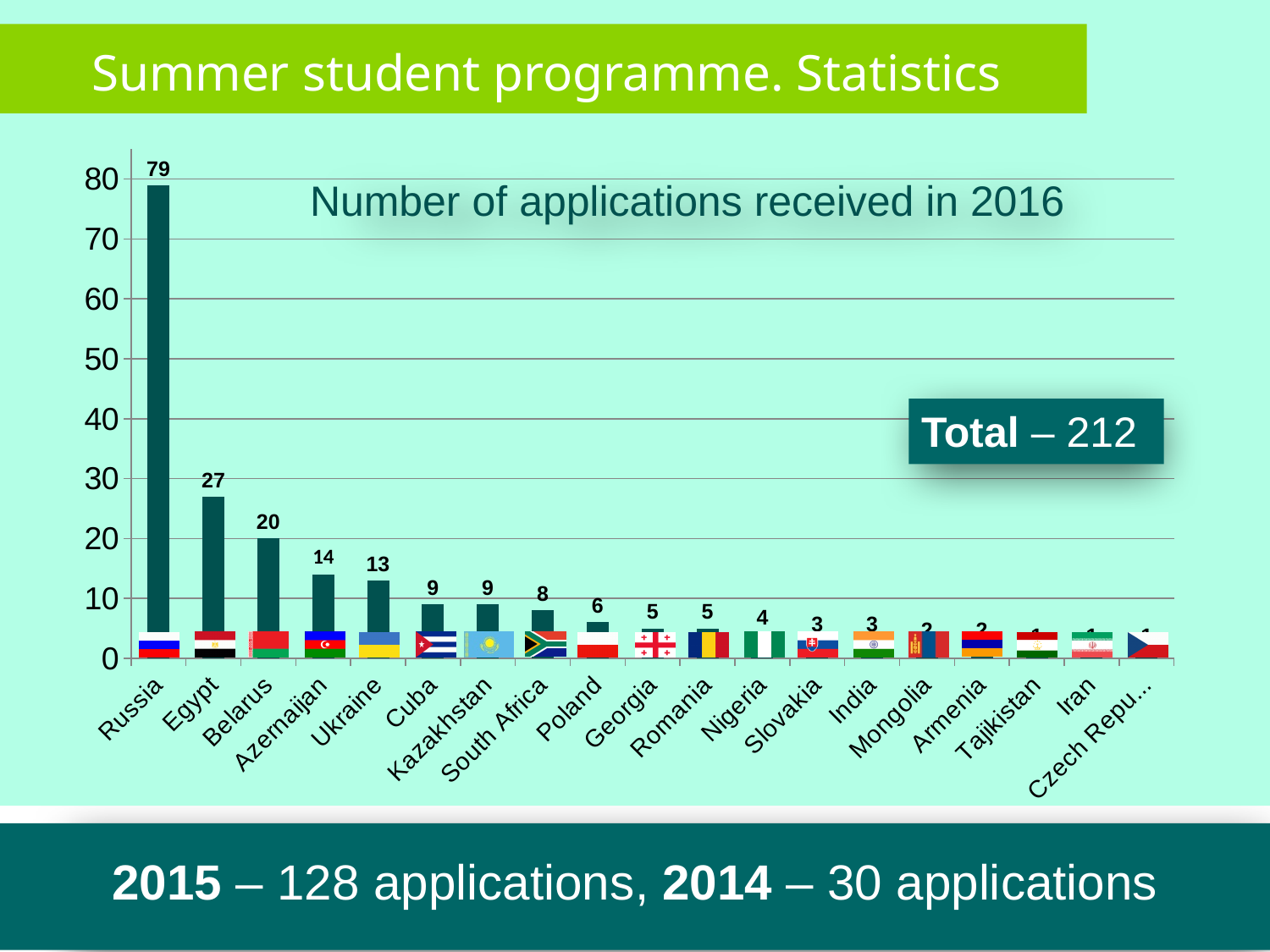
What is the difference between the values for Belarus and Ukraine? 7 How many applications were received from Egypt? 27 Is the value for Belarus greater or less than 30? less Which has more applications, Poland or Nigeria? Poland What is the value shown for South Africa? 8 How many countries are shown on the x axis of the chart? 19 What is the title of the chart? Number of applications received in 2016 How many applications were received from Russia in 2016? 79 What is the value shown for Azerbaijan? 14 What kind of chart is shown on the slide? bar chart Which country has the highest number of applications? Russia What is the difference between the number of applications from Russia and from Egypt? 52